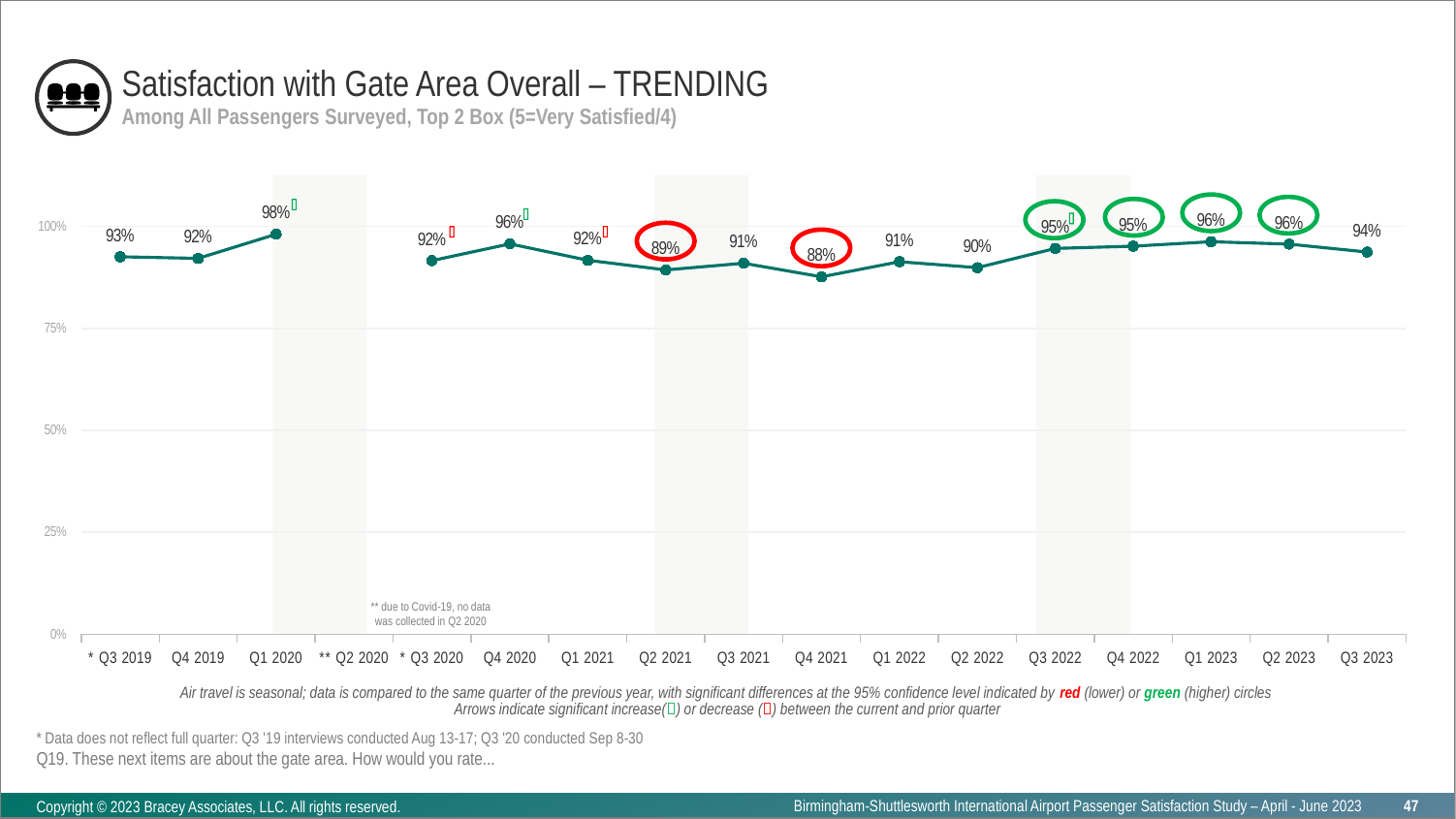
Is the value for Q2 2022 greater or less than 75%? greater What is the satisfaction value for Q4 2021? 88% Which quarter has the lowest satisfaction value? Q4 2021 What is the satisfaction value for Q1 2020? 98% Do the values rise or fall from Q2 2022 to Q1 2023? rise What is the difference between the values for Q1 2020 and Q4 2021? 10 percentage points For which quarter was no data collected due to Covid-19? Q2 2020 Which quarter has the highest satisfaction value? Q1 2020 What is the satisfaction value for Q3 2023? 94% What is the title of the chart? Satisfaction with Gate Area Overall – TRENDING What type of chart is shown on the slide? line chart Which is larger, the value for Q2 2021 or the value for Q3 2022? Q3 2022